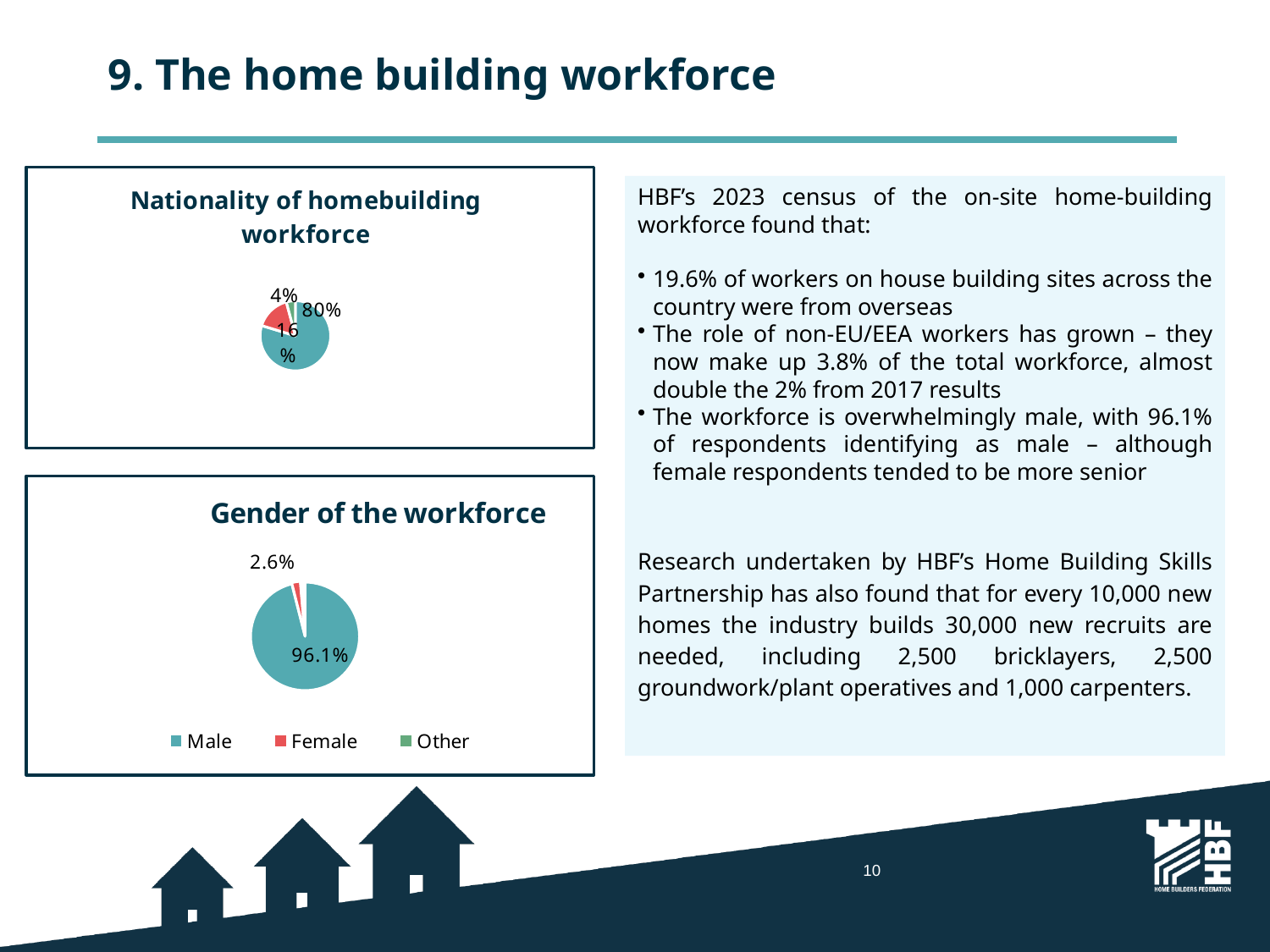
What kind of chart is the 'Nationality of homebuilding workforce' chart? Pie chart In the 'Gender of the workforce' chart, how many categories does the legend list? 3 In the 'Nationality of homebuilding workforce' chart, what is the value of the smallest slice? 4% In the 'Gender of the workforce' chart, what is the difference in percentage points between the Male and Female shares? 93.5 percentage points What kind of chart is the 'Gender of the workforce' chart? Pie chart In the 'Gender of the workforce' chart, which is larger, the Male share or the Female share? Male In the 'Gender of the workforce' chart, which category has the largest slice? Male In the 'Nationality of homebuilding workforce' chart, how many slices does the pie have? 3 In the 'Nationality of homebuilding workforce' chart, what is the value of the largest slice? 80% In the 'Gender of the workforce' chart, what share of the workforce is Female? 2.6% In the 'Gender of the workforce' chart, what share of the workforce is Male? 96.1%